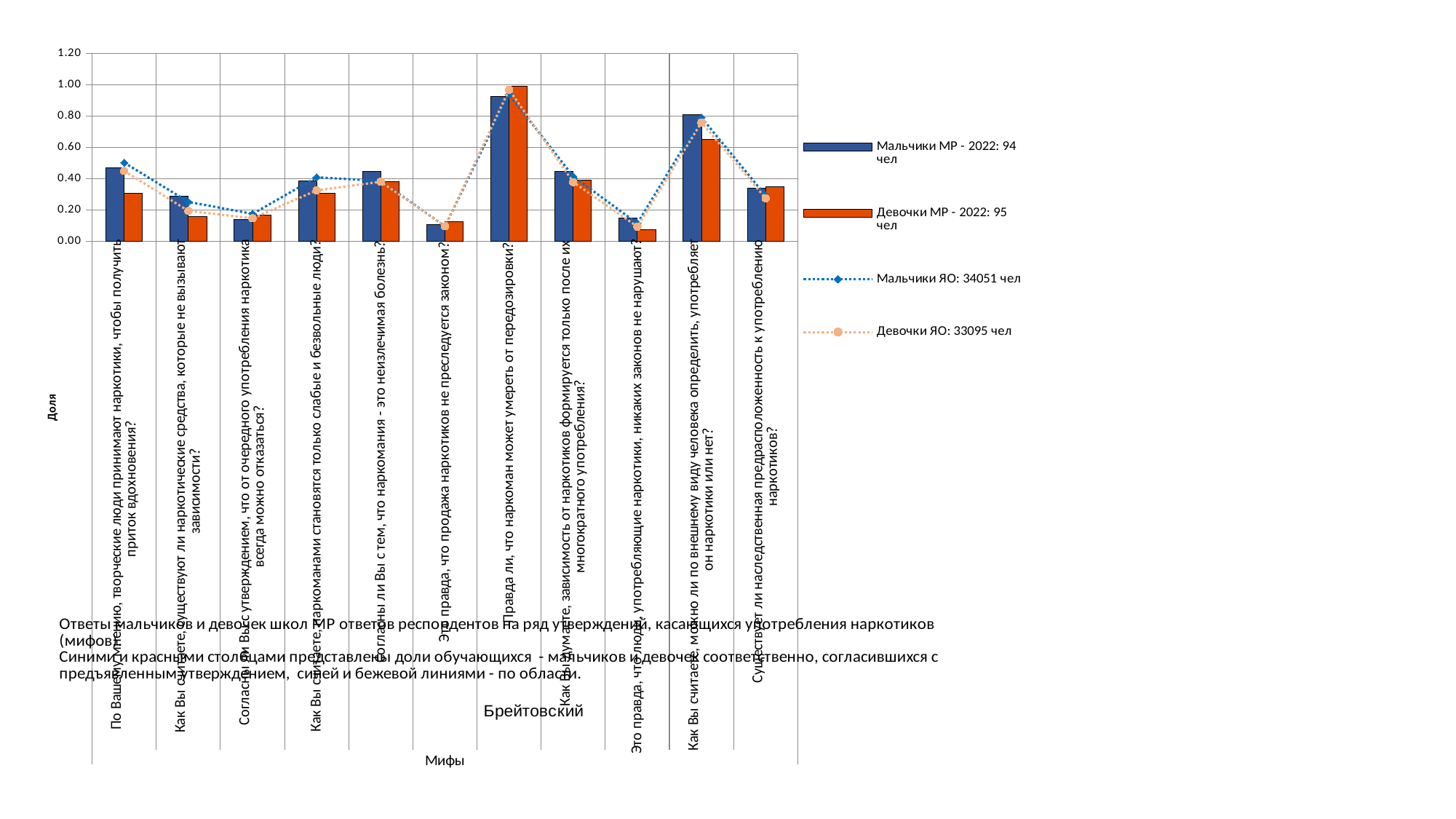
For which myth is the 'Мальчики МР - 2022: 94 чел' bar the highest? Правда ли, что наркоман может умереть от передозировки? For which myth is the 'Девочки МР - 2022: 95 чел' bar the lowest? Это правда, что люди, употребляющие наркотики, никаких законов не нарушают? Is the 'Мальчики МР - 2022: 94 чел' value for 'Это правда, что продажа наркотиков не преследуется законом?' greater or less than 0.20? less Is the 'Мальчики МР - 2022: 94 чел' value for 'Как Вы считаете, можно ли по внешнему виду человека определить, употребляет он наркотики или нет?' greater or less than 0.60? greater How many series does the chart legend list? 4 For which myth is the 'Девочки МР - 2022: 95 чел' bar the highest? Правда ли, что наркоман может умереть от передозировки? What is the title of the chart's vertical axis? Доля Is the 'Девочки МР - 2022: 95 чел' value for 'Правда ли, что наркоман может умереть от передозировки?' greater or less than 0.80? greater What kind of chart is shown on the slide? A combined bar and line chart For which myth is the 'Мальчики МР - 2022: 94 чел' bar the lowest? Это правда, что продажа наркотиков не преследуется законом? For 'Как Вы считаете, можно ли по внешнему виду человека определить, употребляет он наркотики или нет?', which bar is taller: 'Мальчики МР - 2022: 94 чел' or 'Девочки МР - 2022: 95 чел'? Мальчики МР - 2022: 94 чел How many categories (myths) are plotted along the x axis? 11